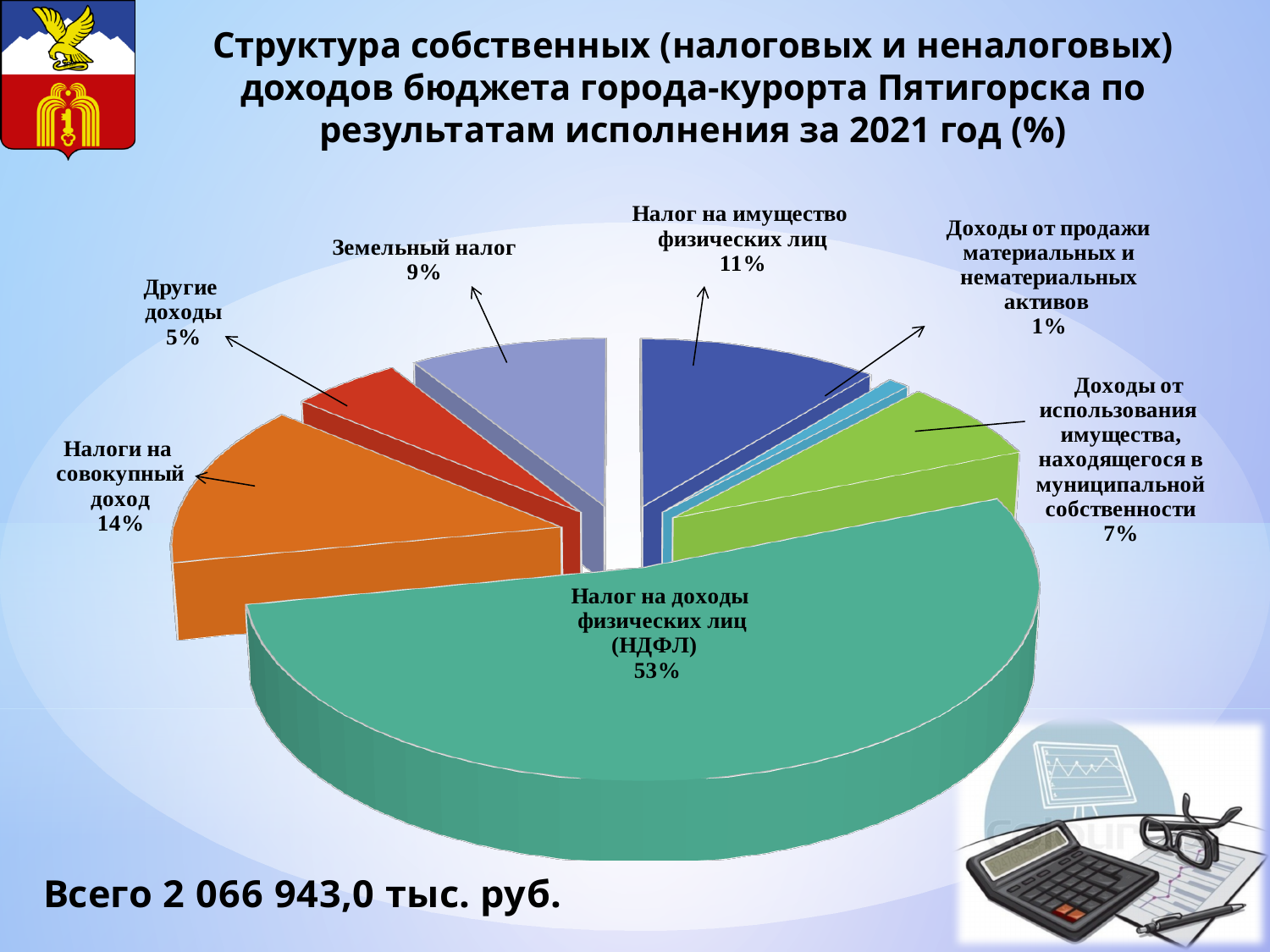
What is the difference between the shares of "Налог на доходы физических лиц (НДФЛ)" and "Налоги на совокупный доход"? 39% What is the value shown for "Налоги на совокупный доход"? 14% What share of the pie does "Налог на доходы физических лиц (НДФЛ)" have? 53% What is the value shown for "Земельный налог"? 9% Which is larger: the share of "Налоги на совокупный доход" or the share of "Земельный налог"? Налоги на совокупный доход Which category has the smallest share of the pie? Доходы от продажи материальных и нематериальных активов What is the value shown for "Доходы от использования имущества, находящегося в муниципальной собственности"? 7% What kind of chart is shown on the slide? Pie chart What total amount is stated below the chart? 2 066 943,0 тыс. руб. What is the difference between the shares of "Налог на имущество физических лиц" and "Другие доходы"? 6% How many slices does the pie chart have? 7 Which category has the largest share of the pie? Налог на доходы физических лиц (НДФЛ)